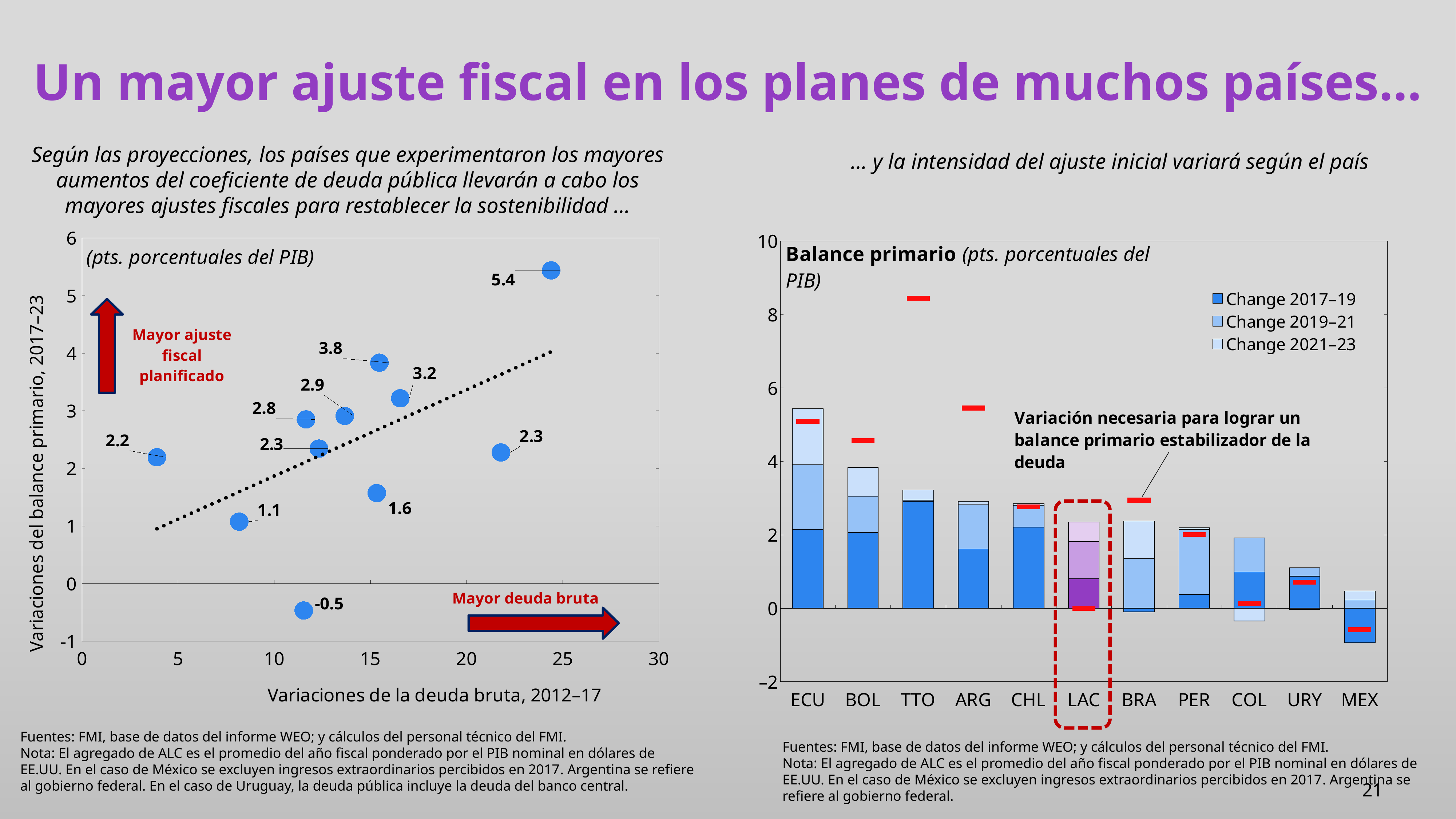
On the left scatter chart, what is the highest labelled value for the change in primary balance? 5.4 On the left scatter chart, what is the label of the x axis? Variaciones de la deuda bruta, 2012–17 On the right 'Balance primario' chart, how many series does the legend list? 3 On the right 'Balance primario' chart, which has the larger total stacked bar, ECU or URY? ECU On the left scatter chart, what is the lowest labelled value for the change in primary balance? -0.5 What kind of chart is the right 'Balance primario' chart? Stacked bar chart On the left scatter chart, does the dotted trend line rise or fall as the change in gross debt increases? Rises On the right 'Balance primario' chart, how many countries or groups are shown on the x axis? 11 On the right 'Balance primario' chart, is the total stacked value for MEX greater or less than 0? less On the right 'Balance primario' chart, is the total stacked value for ECU greater or less than 4? greater What kind of chart is the left chart on the slide? Scatter chart On the left scatter chart, how many data points are plotted? 11